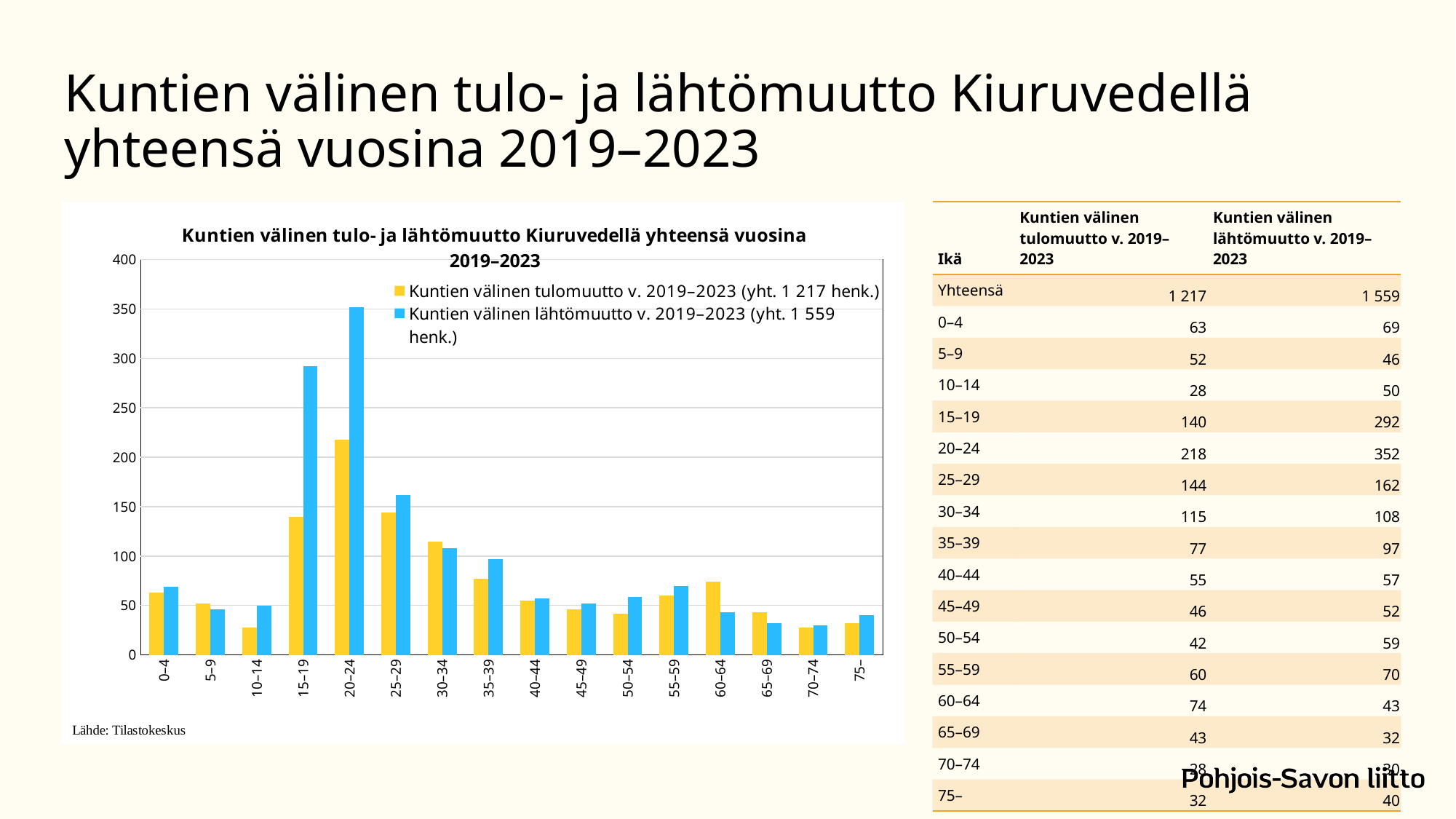
What is the value of Kuntien välinen lähtömuutto v. 2019–2023 for the 15–19 age group? 292 What is the value of Kuntien välinen tulomuutto v. 2019–2023 for the 20–24 age group? 218 Is the value of lähtömuutto for the 15–19 age group greater or less than 250? greater According to the legend, what is the total number of persons for Kuntien välinen lähtömuutto v. 2019–2023? 1 559 henk. Which age group has the highest value for Kuntien välinen lähtömuutto v. 2019–2023? 20–24 How many age groups are shown on the x axis of the chart? 16 Do the lähtömuutto values rise or fall from the 20–24 age group to the 40–44 age group? fall What is the difference between lähtömuutto and tulomuutto for the 20–24 age group? 134 Which age group has the highest value for Kuntien välinen tulomuutto v. 2019–2023? 20–24 For the 60–64 age group, which is larger: tulomuutto or lähtömuutto? tulomuutto How many series does the chart legend list? 2 What kind of chart is shown on the slide? bar chart